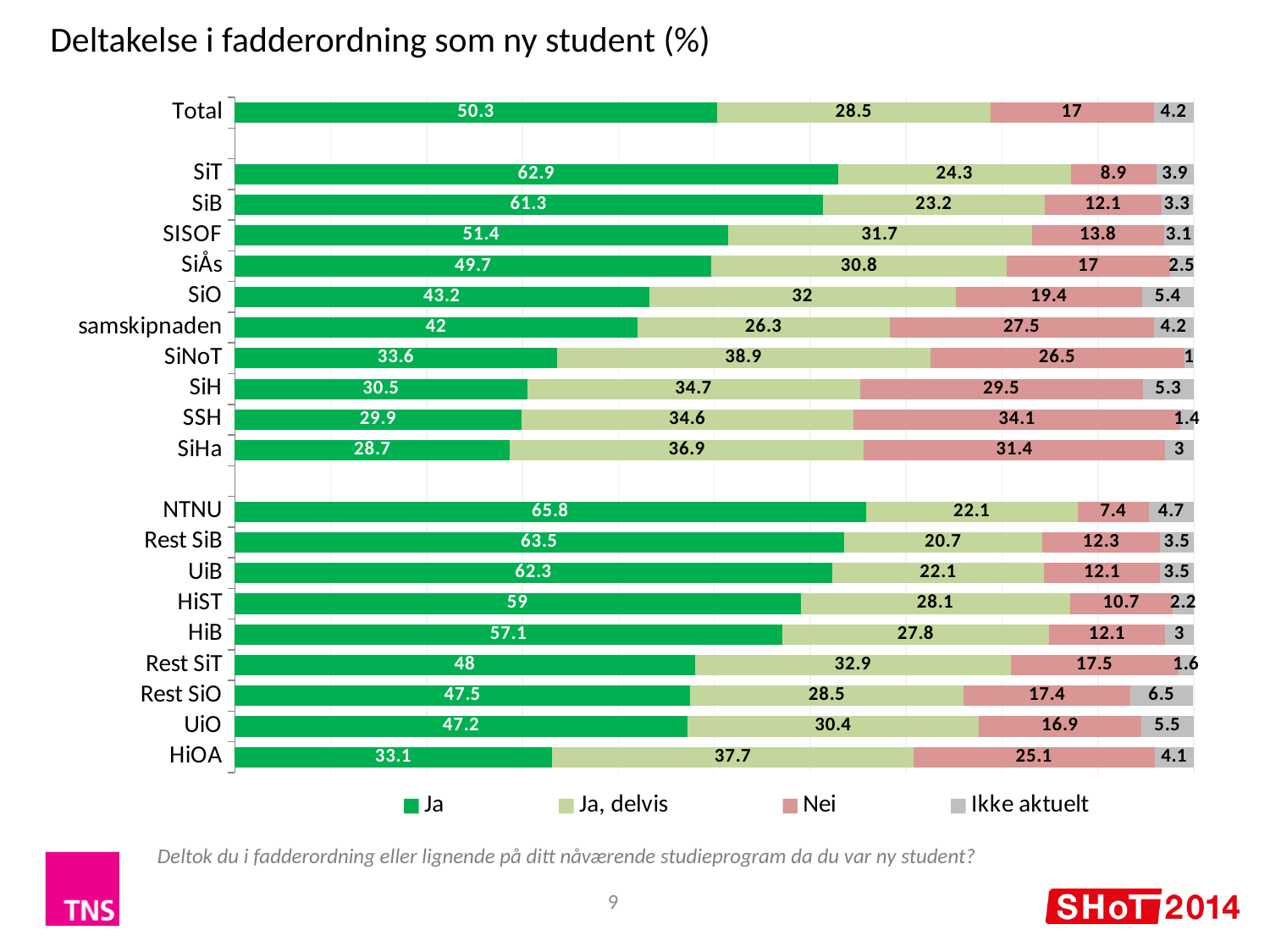
How many series does the legend list? 4 What kind of chart is shown on the slide? Stacked bar chart Which has the larger "Ja, delvis" value, SiNoT or SiHa? SiNoT Which category has the highest "Ja" value? NTNU What is the value of the "Ja" series for NTNU? 65.8 How many categories (rows) are shown in the chart? 20 What is the total of the stacked bar for SiT? 100 What is the "Nei" value for samskipnaden? 27.5 What is the difference between the "Ja" values for SiT and SiB? 1.6 What is the "Ikke aktuelt" value for Rest SiO? 6.5 What is the "Ja, delvis" value for HiOA? 37.7 Which category has the lowest "Ja" value? SiHa